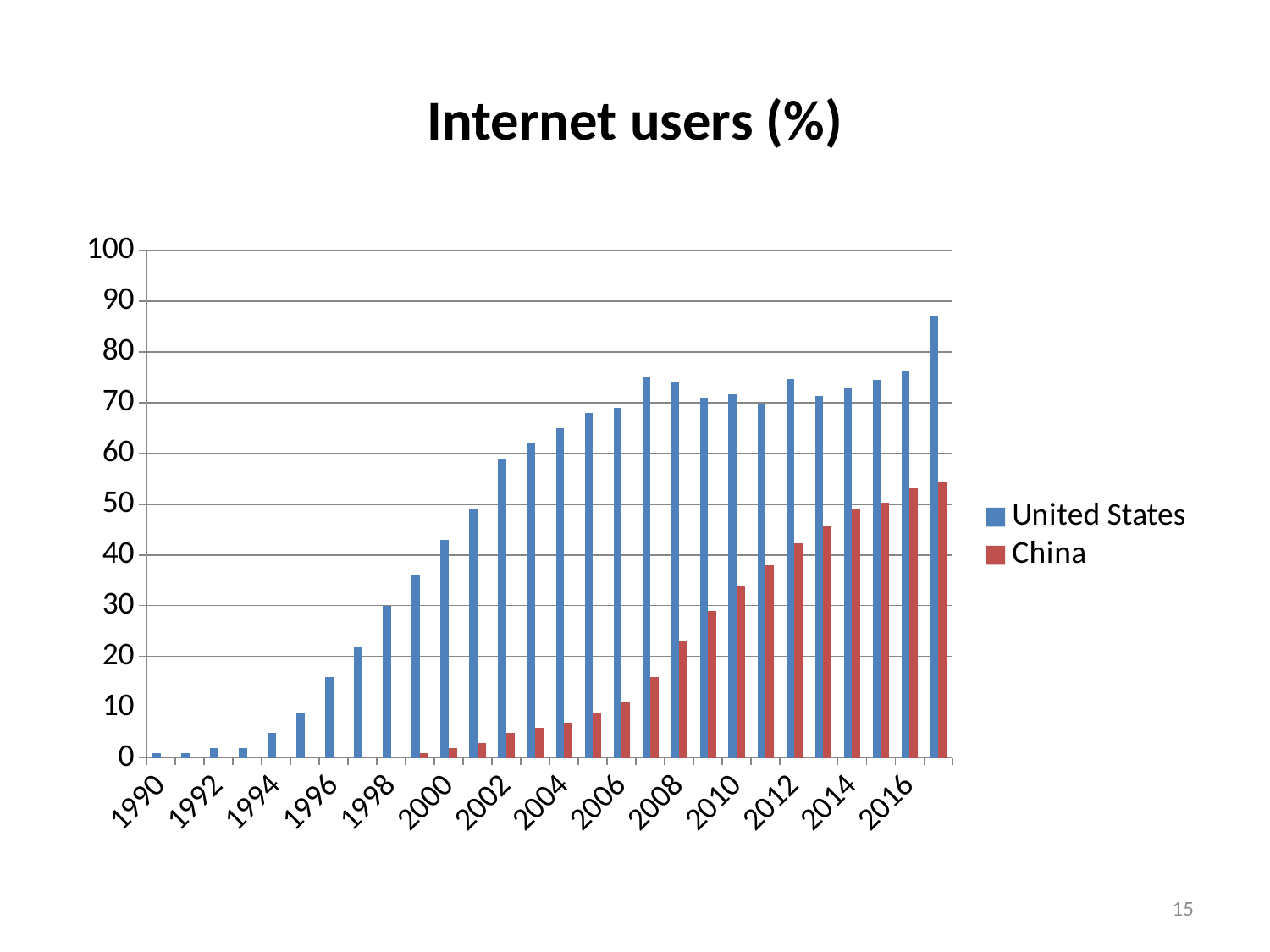
What are the two series named in the legend? United States and China Is the value for China in 2016 greater or less than 60? less Is the value for United States in 2016 greater or less than 70? greater Is the value for United States in 2002 greater or less than 50? greater Do the values for China rise or fall from 2000 to 2016? rise What kind of chart is shown on the slide? Bar chart How many series does the legend list? 2 What is the title of the chart? Internet users (%) Which series has the larger value in 2010, United States or China? United States Which series has the lower value in 2000? China